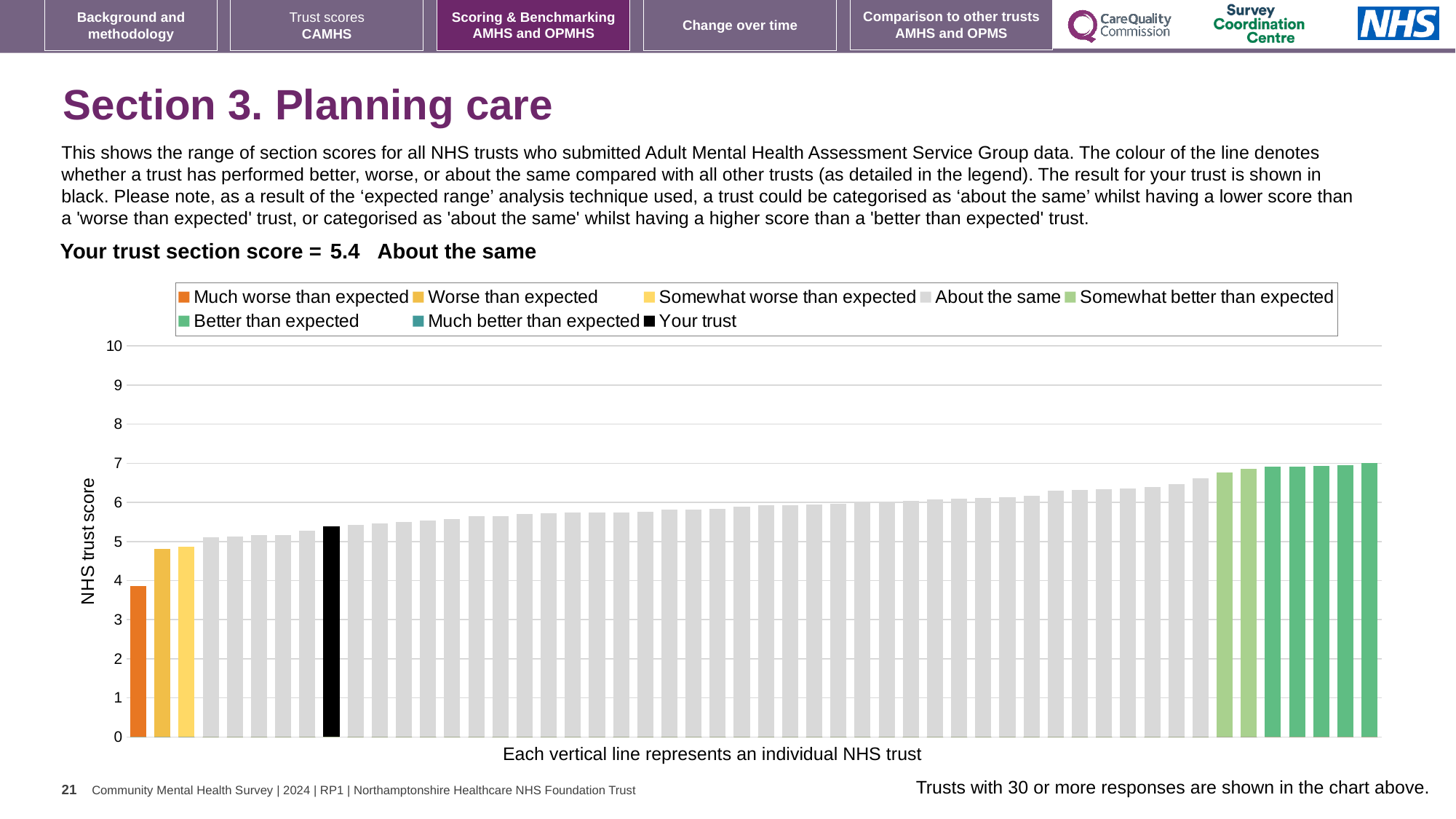
How many bars are coloured as 'Better than expected'? 5 Which legend category does the lowest bar in the chart belong to? Much worse than expected How many entries does the chart legend list? 8 What is the section score for your trust shown on the slide? 5.4 Which is larger: the value for your trust or the value of the leftmost orange bar? your trust Is the value for your trust (black bar) greater or less than 5? greater How many bars are coloured as 'Much worse than expected'? 1 Is the value of the leftmost (orange) bar greater or less than 5? less What is the label on the vertical axis of the chart? NHS trust score Do the bar values rise or fall from left to right across the chart? rise What kind of chart is shown on the slide? bar chart Is the value of the rightmost bar greater or less than 6? greater